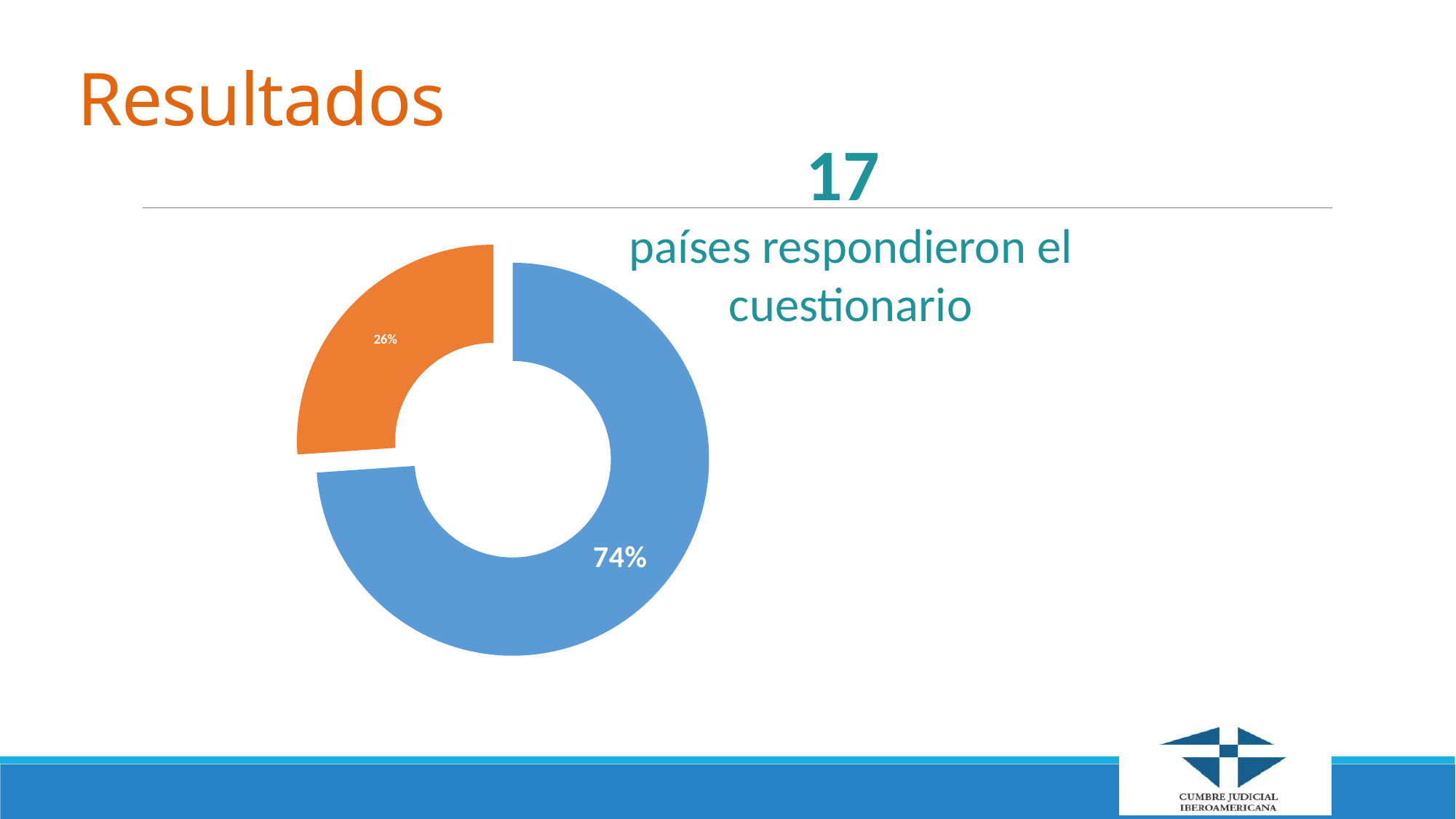
How many slices does the doughnut chart have? 2 According to the text next to the chart, how many countries answered the questionnaire? 17 What kind of chart is shown on the slide? doughnut chart What percentage is shown on the orange slice of the doughnut chart? 26% Which slice of the doughnut chart is the smallest? the orange slice (26%) Which is larger, the blue slice or the orange slice? the blue slice What is the title of the slide containing the doughnut chart? Resultados What is the difference in percentage points between the blue slice and the orange slice? 48 What is the combined total of the two slices in the doughnut chart? 100% What percentage is shown on the blue slice of the doughnut chart? 74% Which slice of the doughnut chart is the largest? the blue slice (74%) Is the value of the orange slice greater or less than 50%? less